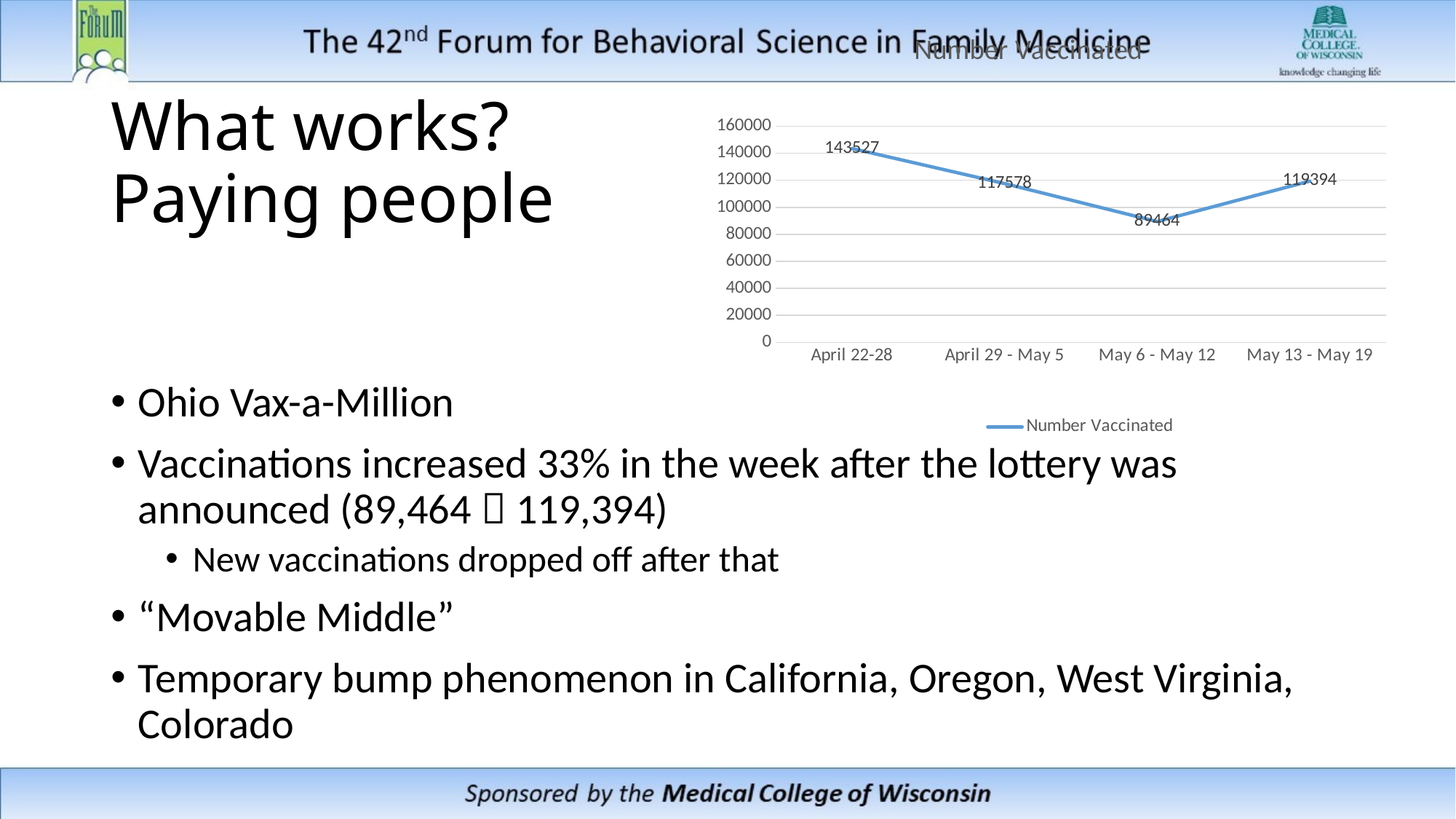
How many time periods are plotted on the chart? 4 What is the number vaccinated for May 13 - May 19? 119394 What is the number vaccinated for April 29 - May 5? 117578 What kind of chart is shown on the slide? line chart Which period has the lowest number vaccinated? May 6 - May 12 What is the number vaccinated for April 22-28? 143527 What is the title of the chart? Number Vaccinated Is the number vaccinated for May 6 - May 12 greater or less than 100000? less What is the number vaccinated for May 6 - May 12? 89464 What is the difference in number vaccinated between May 13 - May 19 and May 6 - May 12? 29930 Which period has the highest number vaccinated? April 22-28 Which period has a larger number vaccinated, April 29 - May 5 or May 13 - May 19? May 13 - May 19